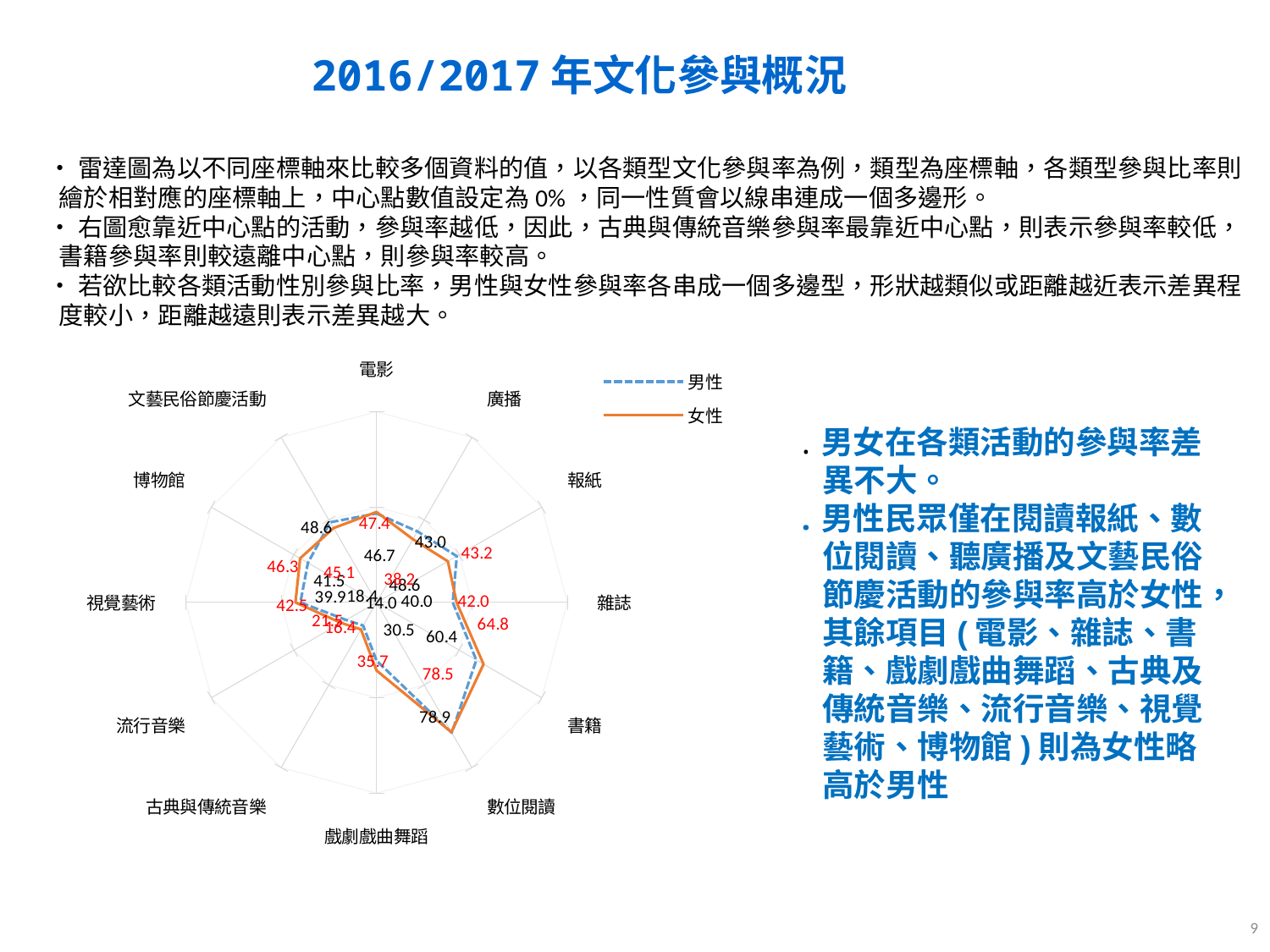
What is the largest data label value shown on the radar chart? 78.9 Which category has the higher participation rate in the radar chart, 雜誌 or 流行音樂? 雜誌 Which category has the higher participation rate in the radar chart, 書籍 or 古典與傳統音樂? 書籍 How many categories (axes) does the radar chart have? 12 What is the title of the slide containing the radar chart? 2016/2017 年文化參與概況 Which category lies closest to the centre of the radar chart, i.e. has the lowest participation rate? 古典與傳統音樂 What is the smallest data label value shown on the radar chart? 14.0 Which category lies farthest from the centre of the radar chart, i.e. has the highest participation rate? 數位閱讀 What are the two series named in the legend of the radar chart? 男性 and 女性 How many series does the legend of the radar chart list? 2 Which series is drawn with a dashed blue line in the radar chart? 男性 What kind of chart is shown on the slide? Radar chart